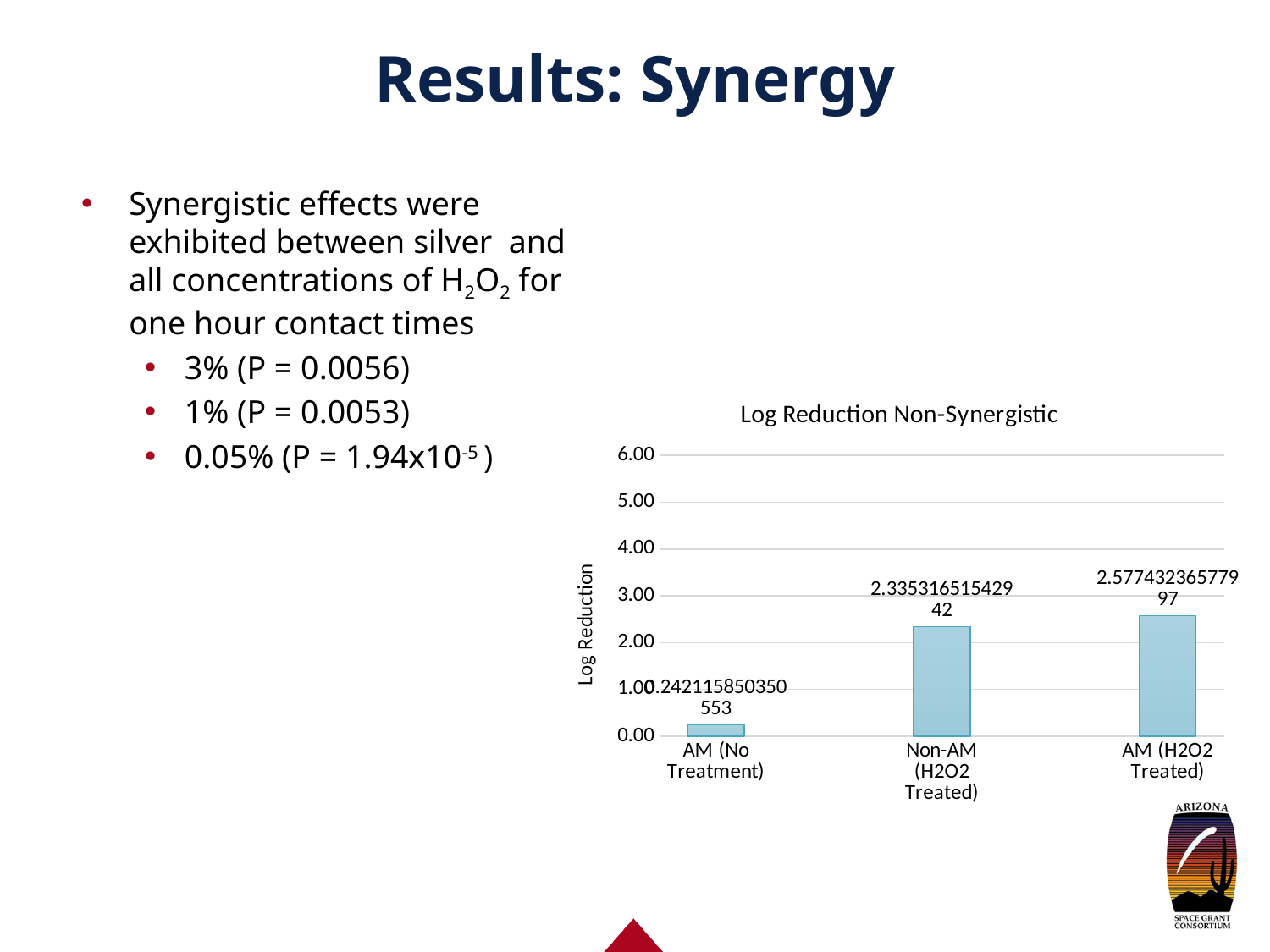
How many categories are plotted in the chart? 3 What type of chart is shown on the slide? Bar chart What is the value for AM (No Treatment)? 0.242115850350553 What is the title of the chart on the slide? Log Reduction Non-Synergistic Which category has the lowest log reduction? AM (No Treatment) Which is larger, the value for Non-AM (H2O2 Treated) or the value for AM (H2O2 Treated)? AM (H2O2 Treated) What is the value for Non-AM (H2O2 Treated)? 2.33531651542942 What is the label on the vertical axis of the chart? Log Reduction Is the value for AM (No Treatment) greater or less than 1.00? less Is the value for Non-AM (H2O2 Treated) greater or less than 2.00? greater Which category has the highest log reduction? AM (H2O2 Treated) What is the value for AM (H2O2 Treated)? 2.57743236577997